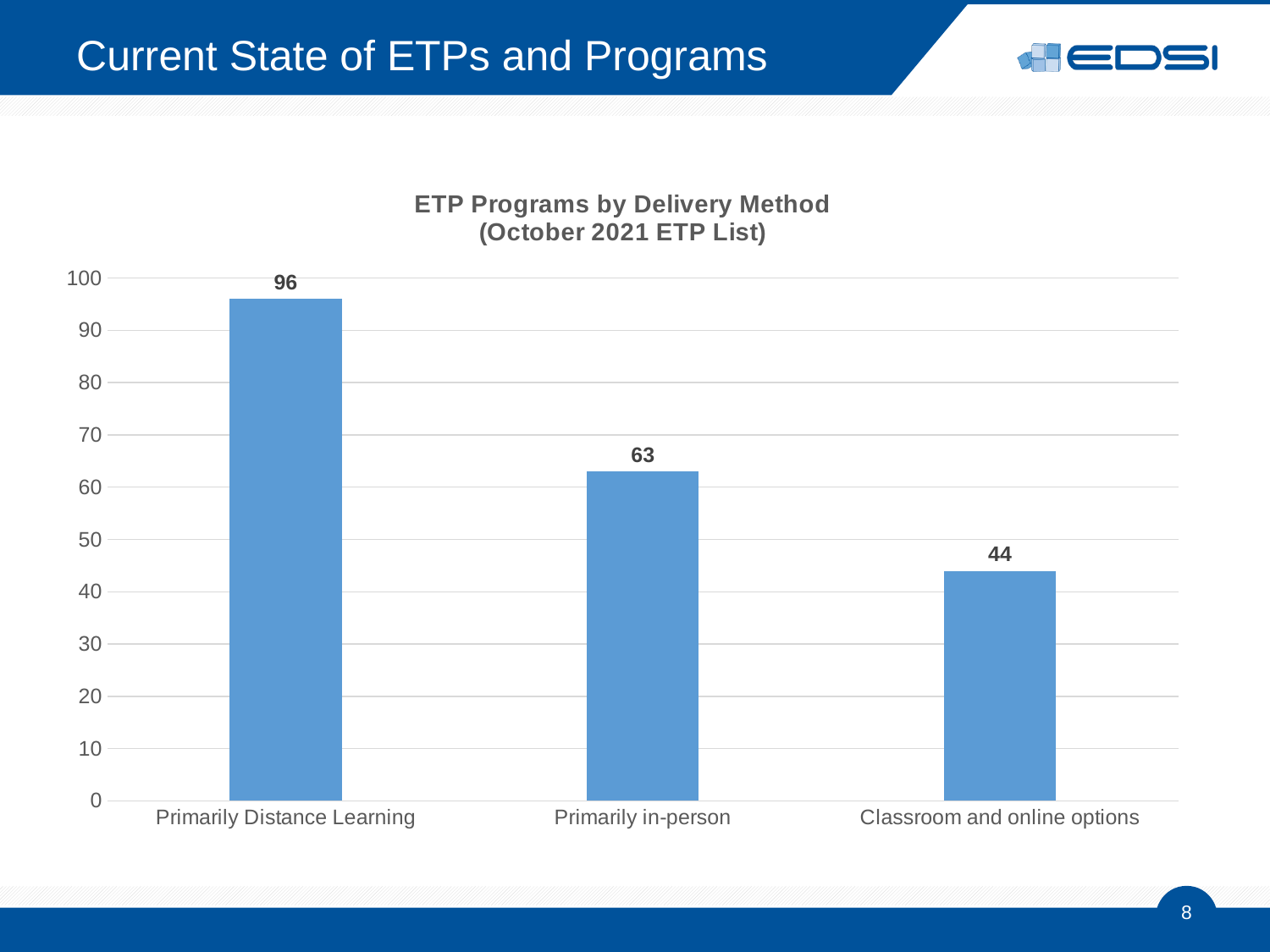
What is the difference between the values for Primarily Distance Learning and Primarily in-person? 33 How many delivery method categories are shown in the chart? 3 What is the difference between the values for Primarily in-person and Classroom and online options? 19 What is the value for Primarily Distance Learning? 96 Which delivery method has the highest number of ETP programs? Primarily Distance Learning What kind of chart is shown on the slide? bar chart What is the value for Primarily in-person? 63 Which delivery method has the lowest number of ETP programs? Classroom and online options What is the value for Classroom and online options? 44 What is the title of the chart? ETP Programs by Delivery Method (October 2021 ETP List) Is the value for Primarily in-person greater or less than 70? less Which is larger, the value for Primarily in-person or the value for Classroom and online options? Primarily in-person